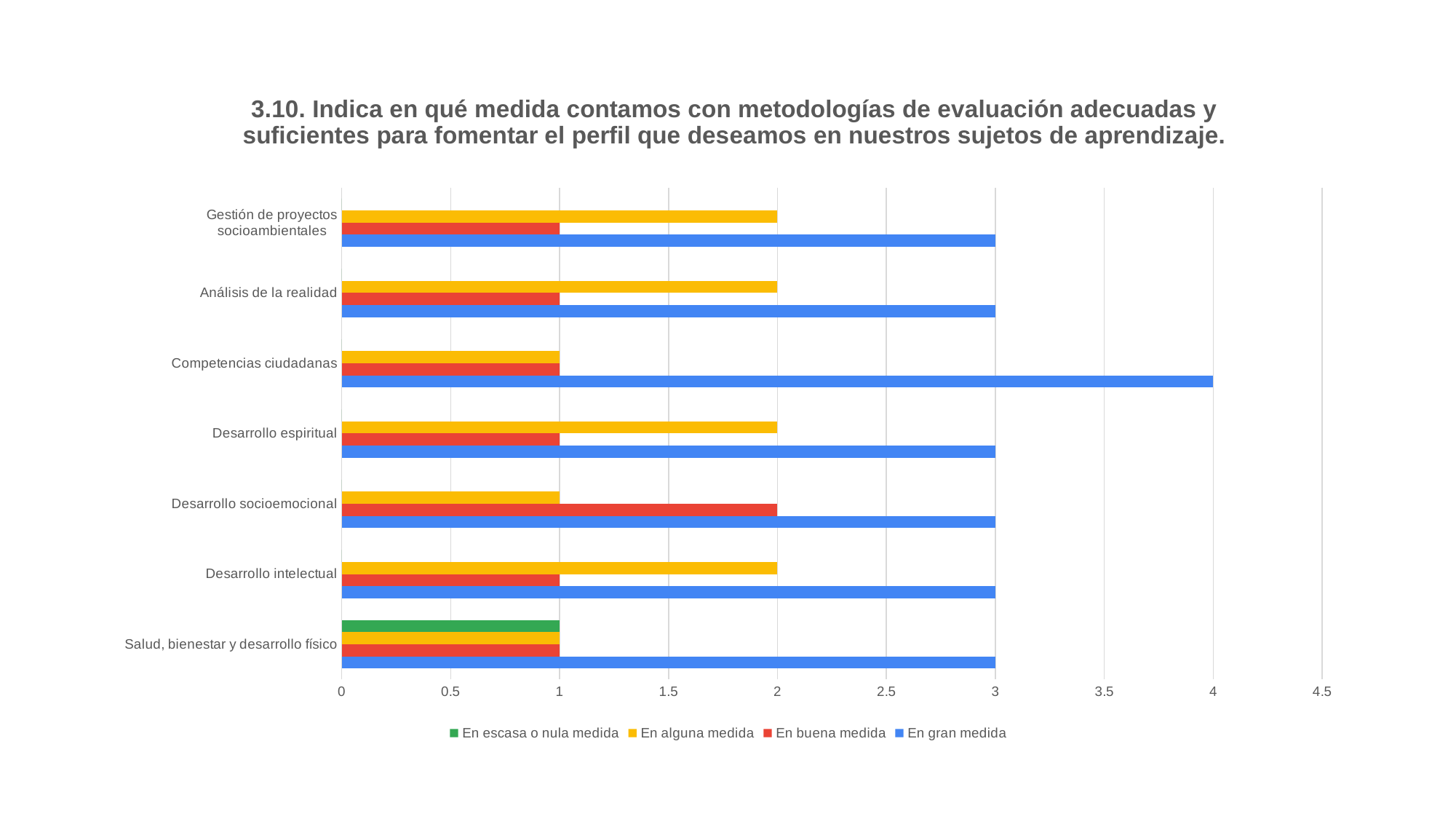
How many categories are listed on the vertical axis of the chart? 7 How many series does the legend list? 4 What is the value of 'En gran medida' for Competencias ciudadanas? 4 What is the value of 'En buena medida' for Desarrollo socioemocional? 2 What colour represents 'En gran medida' in the chart? blue For Desarrollo socioemocional, which is larger: 'En buena medida' or 'En alguna medida'? En buena medida What kind of chart is shown on the slide? bar chart What is the difference between the 'En gran medida' value for Competencias ciudadanas and the 'En gran medida' value for Análisis de la realidad? 1 What is the value of 'En escasa o nula medida' for Salud, bienestar y desarrollo físico? 1 Which category has the highest value for 'En gran medida'? Competencias ciudadanas What is the value of 'En alguna medida' for Desarrollo intelectual? 2 Which category is the only one with a bar for 'En escasa o nula medida'? Salud, bienestar y desarrollo físico